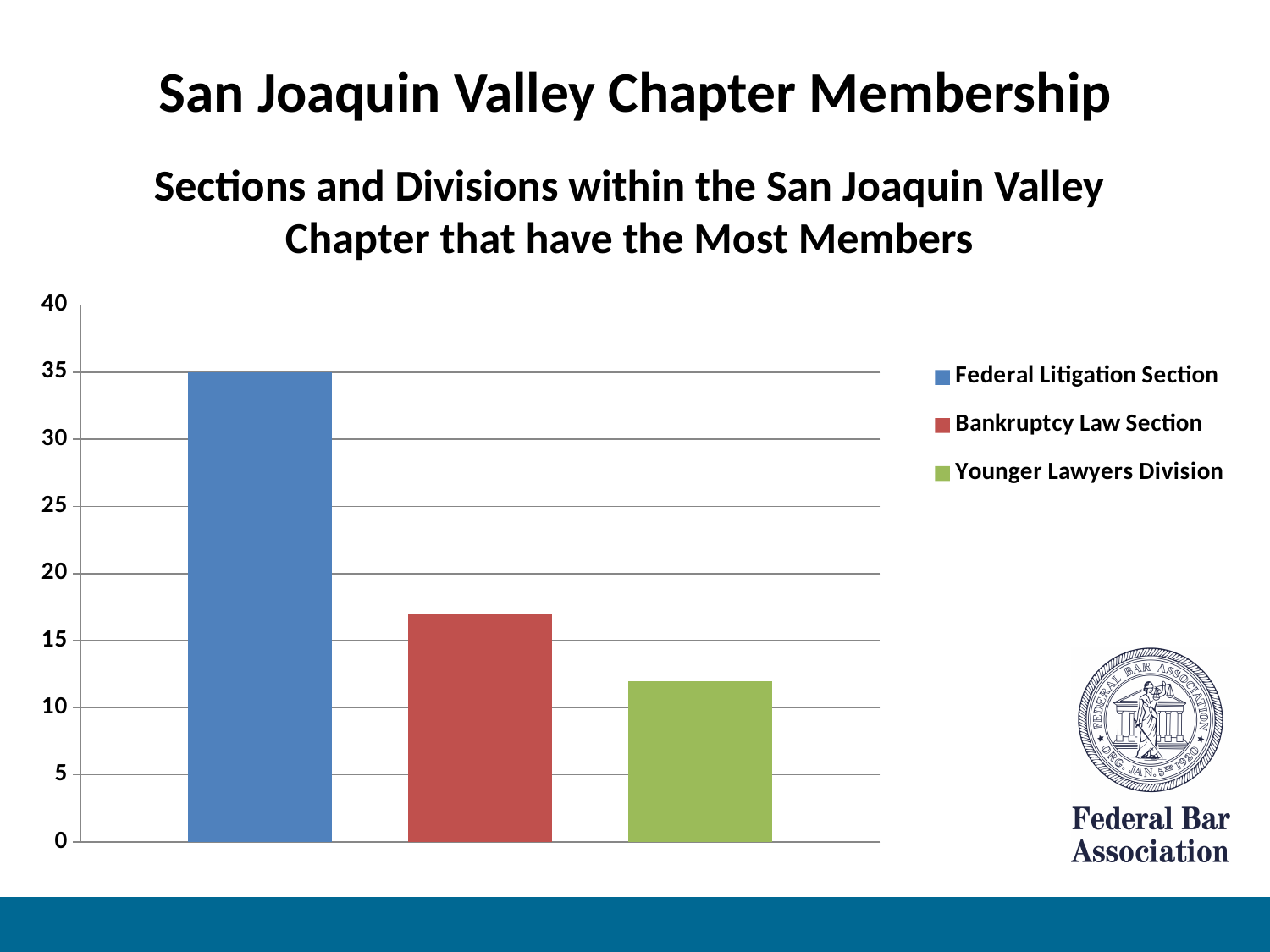
What kind of chart is shown on the slide? Bar chart Is the value for Younger Lawyers Division greater or less than 15? less Which section or division has the lowest value? Younger Lawyers Division Is the value for Bankruptcy Law Section greater or less than 15? greater Which is larger, the value for Bankruptcy Law Section or the value for Younger Lawyers Division? Bankruptcy Law Section How many entries does the legend list? 3 How many bars are plotted in the chart? 3 What is the value for Federal Litigation Section? 35 What colour is the bar for Younger Lawyers Division? Green Which section or division has the highest value? Federal Litigation Section Is the value for Bankruptcy Law Section greater or less than 20? less